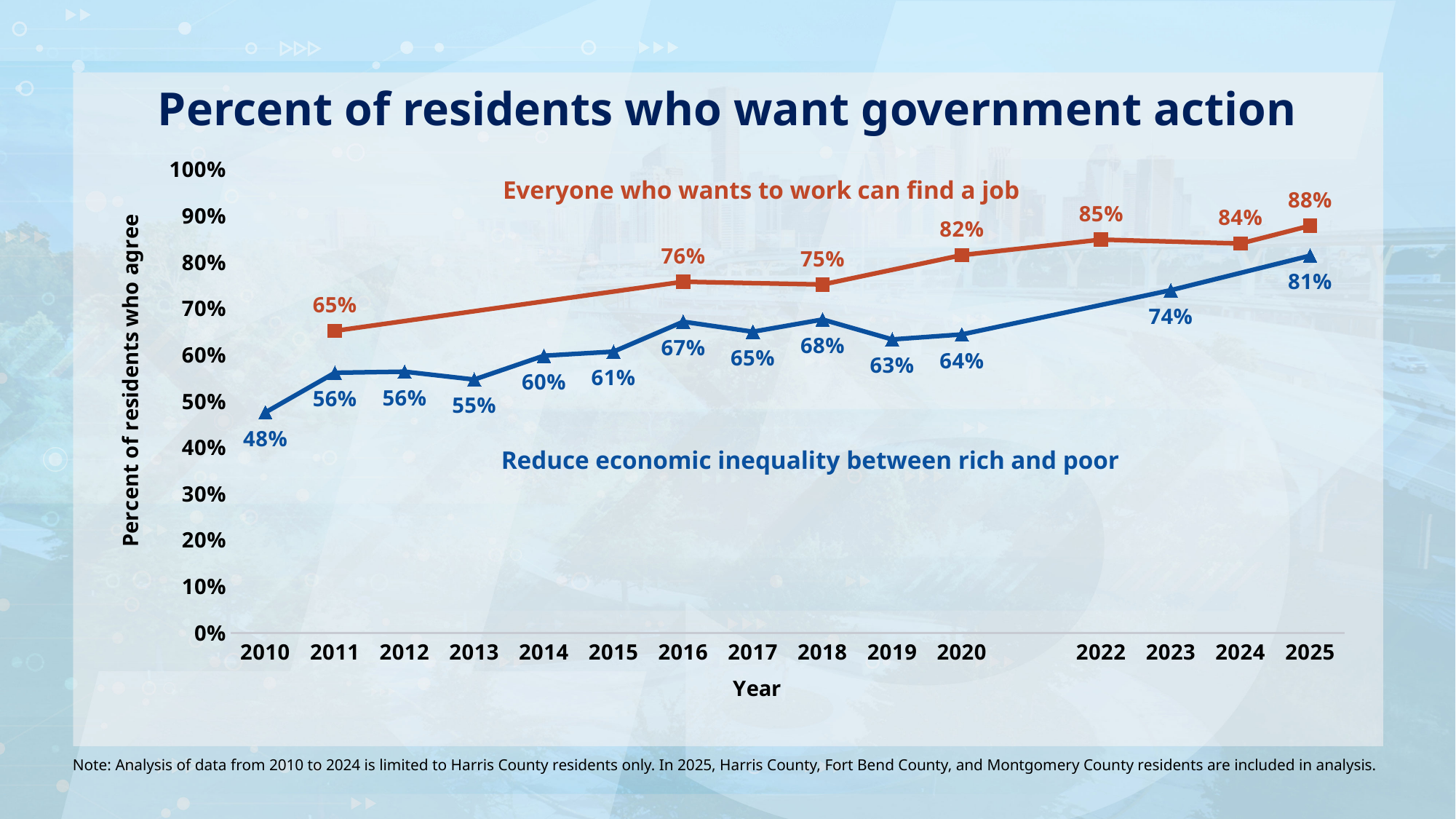
In 2025, how many percentage points higher is "Everyone who wants to work can find a job" than "Reduce economic inequality between rich and poor"? 7 percentage points How many data points are plotted for "Reduce economic inequality between rich and poor"? 13 In which year does the "Everyone who wants to work can find a job" line reach its highest value? 2025 What percent of residents agreed with "Reduce economic inequality between rich and poor" in 2010? 48% How many data series are plotted on the chart? 2 In which year is the "Reduce economic inequality between rich and poor" line at its lowest value? 2010 By how many percentage points did "Reduce economic inequality between rich and poor" increase from 2010 to 2025? 33 percentage points What is the value for "Everyone who wants to work can find a job" in 2020? 82% Does the "Everyone who wants to work can find a job" line generally rise or fall from 2011 to 2025? Rise What kind of chart is shown on the slide? Line chart What is the value for "Everyone who wants to work can find a job" in 2025? 88% In 2016, which series has the higher value? Everyone who wants to work can find a job